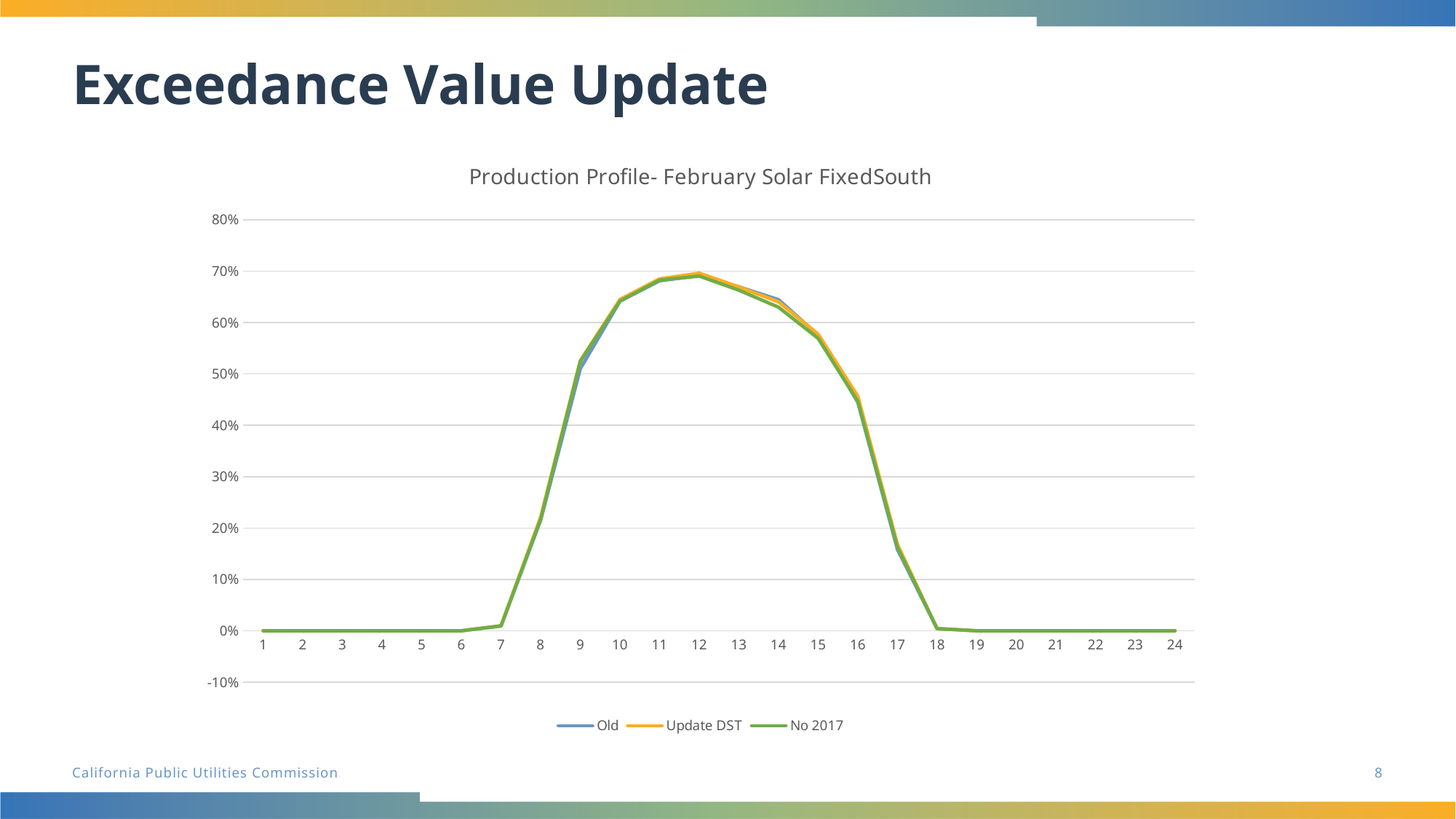
How many points are plotted along the x axis for each series? 24 Do the values rise or fall from hour 7 to hour 12? rise What are the three series named in the legend? Old, Update DST, No 2017 How many series does the legend list? 3 Is the value for the Old series at hour 17 greater or less than 30%? less Is the value for the Update DST series at hour 16 greater or less than 40%? greater What is the title of the chart? Production Profile- February Solar FixedSouth Is the value for the Old series at hour 12 greater or less than 60%? greater Do the values rise or fall from hour 12 to hour 18? fall What kind of chart is shown on the slide? line chart Which is larger for the No 2017 series: the value at hour 10 or the value at hour 17? hour 10